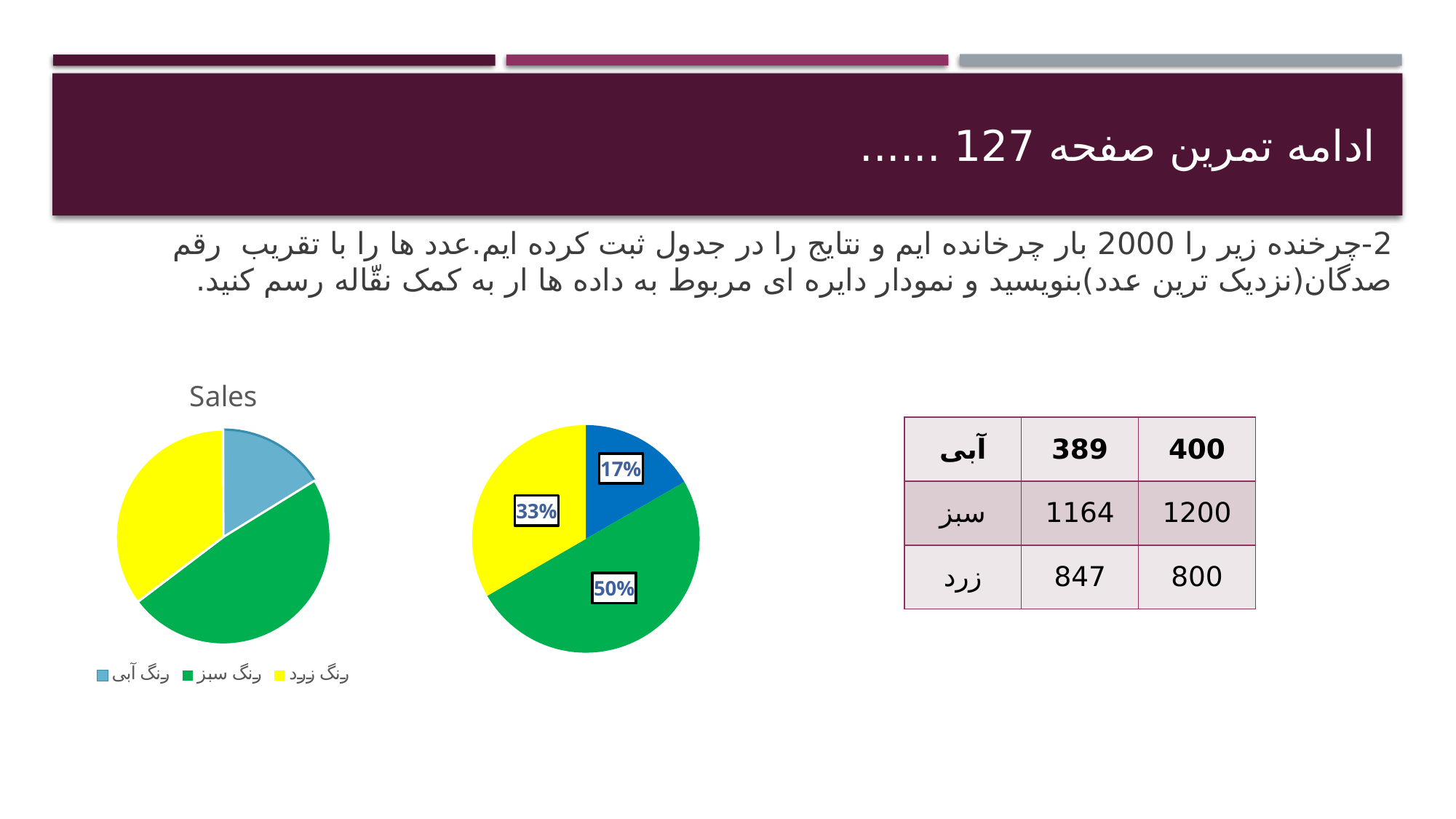
In the chart titled "Sales", which category has the largest slice? رنگ سبز How many entries does the legend of the chart titled "Sales" list? 3 What kind of chart is the chart titled "Sales" on the left of the slide? pie chart In the middle pie chart with percentage labels, what share does the blue slice have? 17% What is the title of the pie chart on the left of the slide? Sales In the middle pie chart with percentage labels, what share does the yellow slice have? 33% In the chart titled "Sales", which category has the smallest slice? رنگ آبی In the middle pie chart with percentage labels, what share does the green slice have? 50% What kind of chart is the chart in the middle of the slide with percentage labels? pie chart In the chart titled "Sales", which slice is larger, رنگ زرد or رنگ آبی? رنگ زرد In the middle pie chart with percentage labels, how many slices are there? 3 How many slices does the chart titled "Sales" have? 3